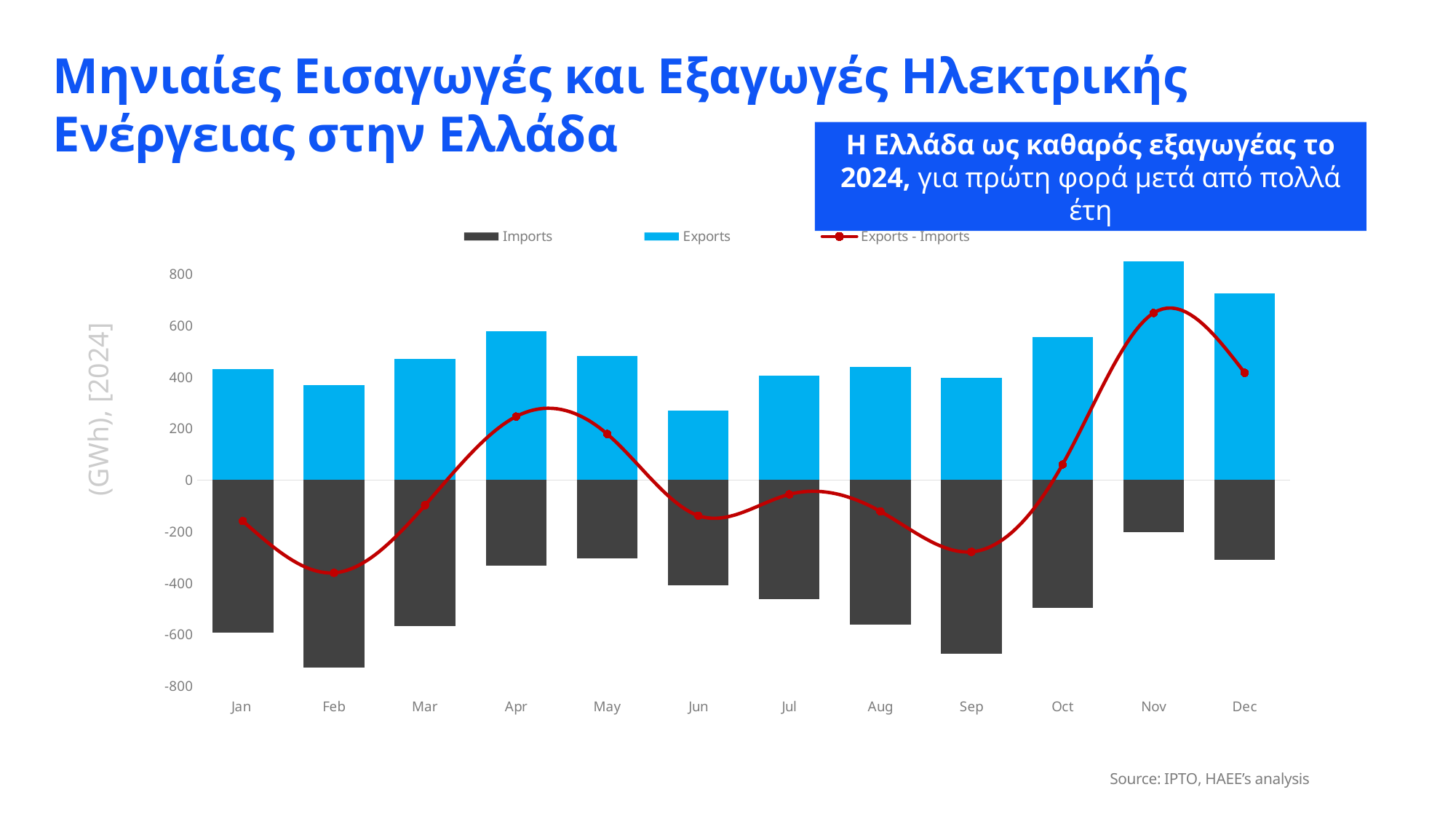
Do the Exports bars rise or fall from Sep to Nov? rise What kind of chart is shown on the slide? A bar chart with a line series How many series does the chart legend list? 3 In which month does the Exports - Imports line reach its highest point? Nov Which month has the lowest Exports bar? Jun How many months are shown on the x axis of the chart? 12 Is the Imports value for Feb greater or less than -600? less Is the Exports value for Jun greater or less than 400? less Is the Exports value for Nov greater or less than 800? greater Which month has the larger Exports bar, Apr or Jun? Apr Which month has the highest Exports bar? Nov In which month does the Exports - Imports line reach its lowest point? Feb